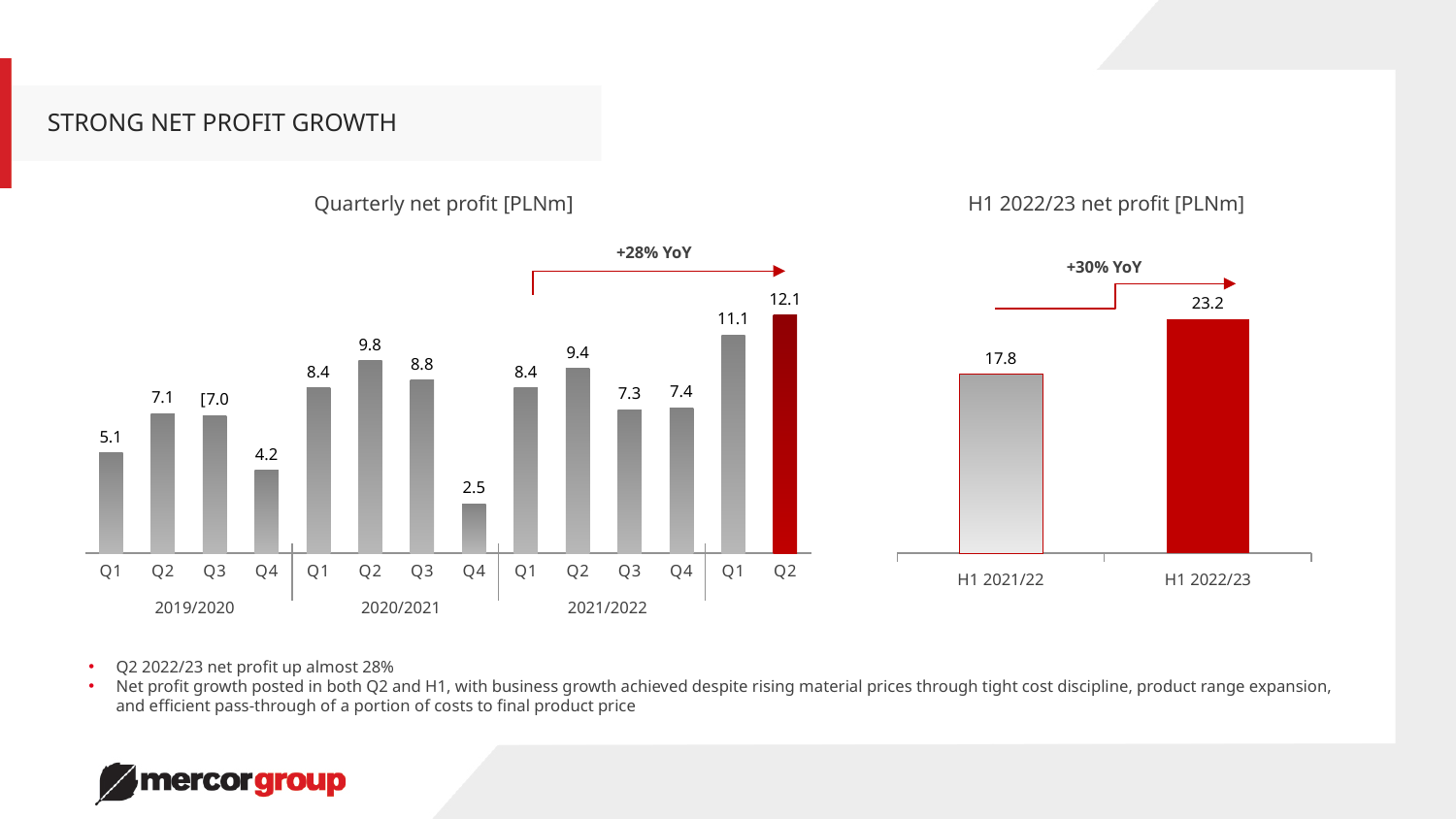
In the Quarterly net profit chart, what YoY growth percentage is annotated above the Q2 bar? +28% YoY In the Quarterly net profit chart, what is the value for Q4 2020/2021? 2.5 How many bars are plotted in the Quarterly net profit chart? 14 In the H1 2022/23 net profit chart, what YoY growth percentage is annotated above the bars? +30% YoY What kind of chart is the Quarterly net profit chart? Bar chart In the H1 2022/23 net profit chart, what is the difference between H1 2022/23 and H1 2021/22? 5.4 In the Quarterly net profit chart, what is the value for Q2 2020/2021? 9.8 In the Quarterly net profit chart, which quarter has the lowest net profit? Q4 2020/2021 (2.5) In the Quarterly net profit chart, which is larger: Q3 2021/2022 or Q4 2021/2022? Q4 2021/2022 (7.4) In the Quarterly net profit chart, which quarter has the highest net profit? Q2 (2022/23, 12.1) In the H1 2022/23 net profit chart, what is the value for H1 2021/22? 17.8 In the Quarterly net profit chart, what is the difference between the Q2 value of 12.1 and the Q1 value of 11.1 for the latest year? 1.0